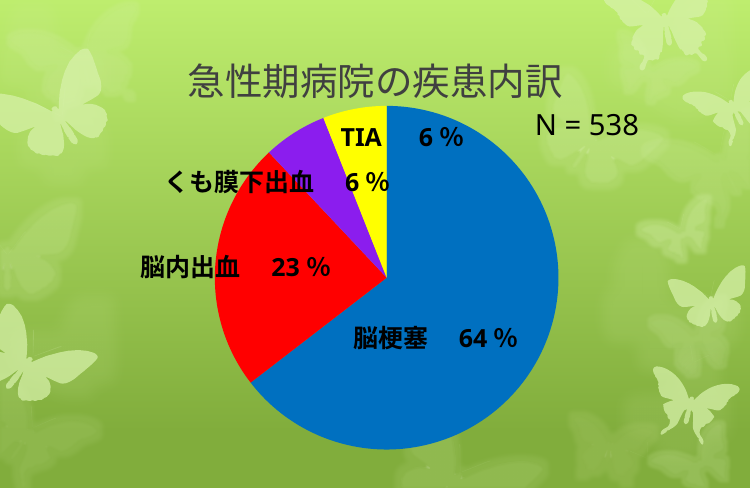
What is the difference between the shares of 脳梗塞 and 脳内出血? 41 % What kind of chart is shown on the slide? pie chart What is the combined share of くも膜下出血 and TIA? 12 % What is the value of N shown on the slide? 538 What is the share for TIA? 6 % What is the share for くも膜下出血? 6 % How many categories are shown in the pie chart? 4 What is the share for 脳梗塞? 64 % What is the title of the chart? 急性期病院の疾患内訳 Which is larger, the share for 脳内出血 or the share for くも膜下出血? 脳内出血 What is the share for 脳内出血? 23 % Which category has the largest slice of the pie? 脳梗塞